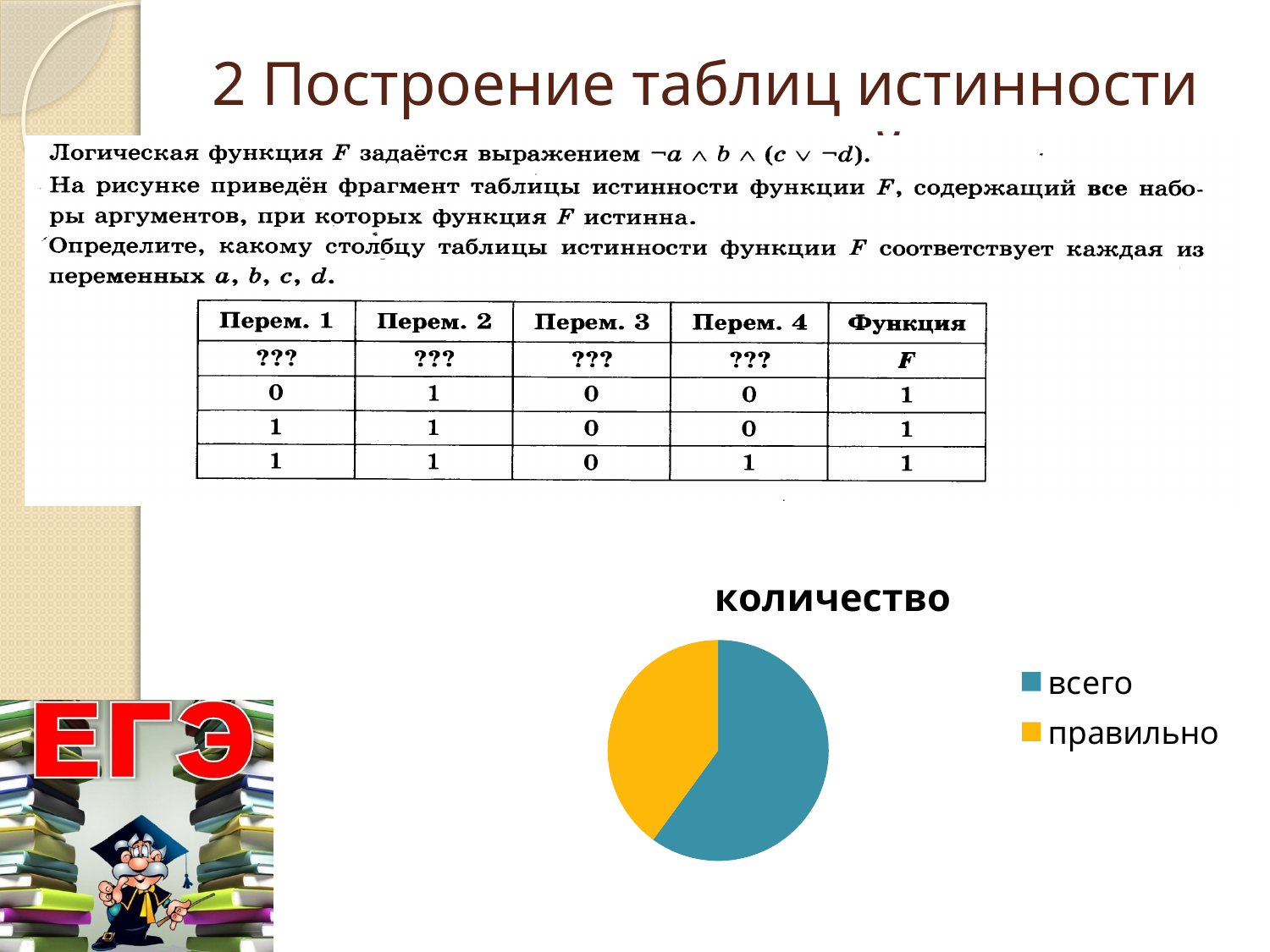
What is the title of the pie chart? количество What kind of chart is shown on the slide? pie chart Which category has the smallest slice in the pie chart? правильно What colour is the "правильно" slice in the pie chart? yellow How many slices does the pie chart have? 2 Which slice of the pie chart is larger, "всего" or "правильно"? всего How many entries does the legend of the pie chart list? 2 Which category has the largest slice in the pie chart? всего